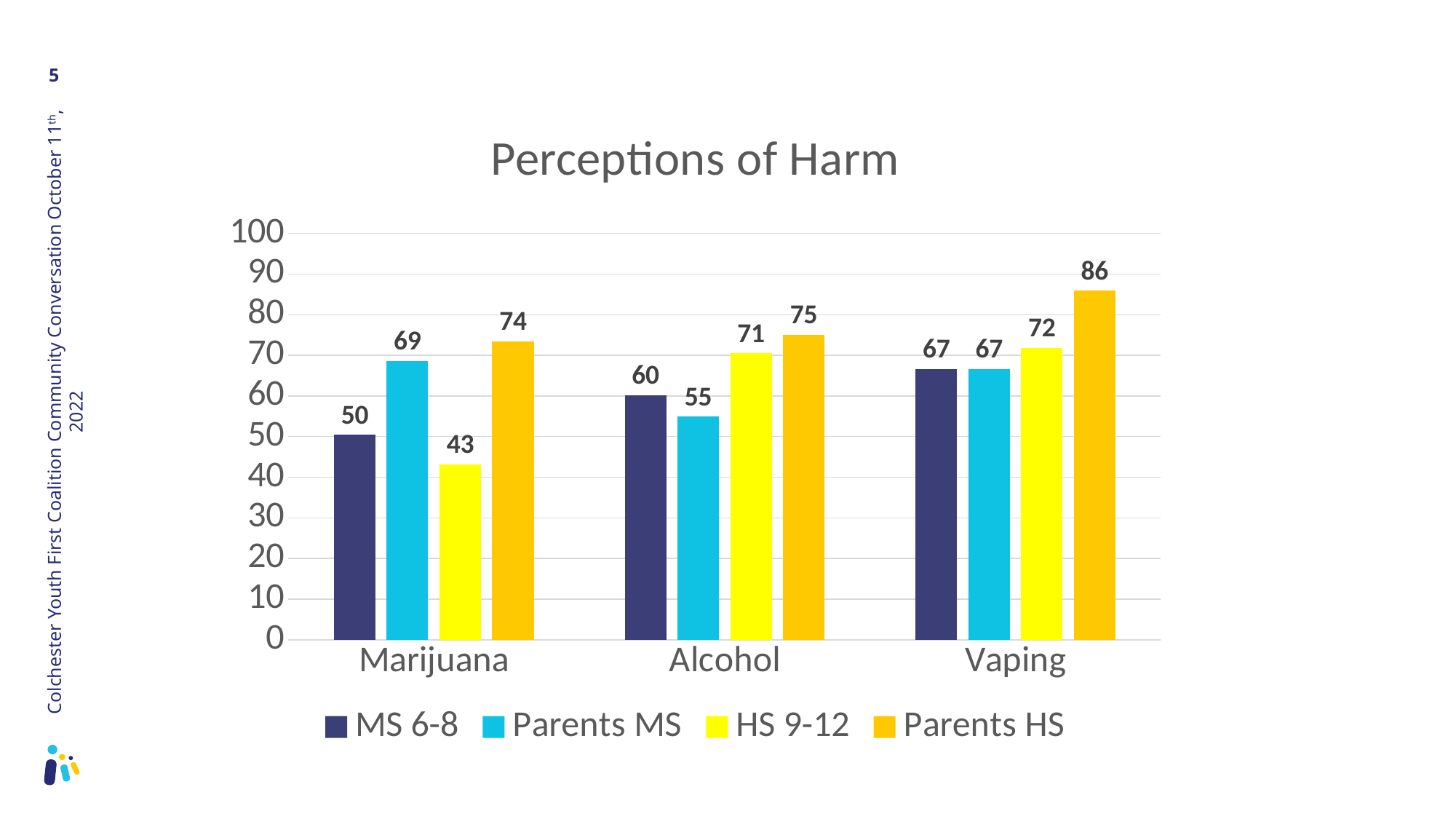
How many series does the legend list? 4 What kind of chart is shown on the slide? Bar chart What is the value for HS 9-12 in the Marijuana category? 43 What is the value for Parents MS in the Alcohol category? 55 Which category has the lowest value for HS 9-12? Marijuana Which category has the highest value for Parents HS? Vaping How many categories are shown on the x axis? 3 What is the title of the chart? Perceptions of Harm What is the value for Parents HS in the Vaping category? 86 What is the difference between the Parents HS and MS 6-8 values for Marijuana? 24 Which is larger for Alcohol: the MS 6-8 value or the Parents MS value? MS 6-8 Do the MS 6-8 values rise or fall from Marijuana to Vaping? Rise